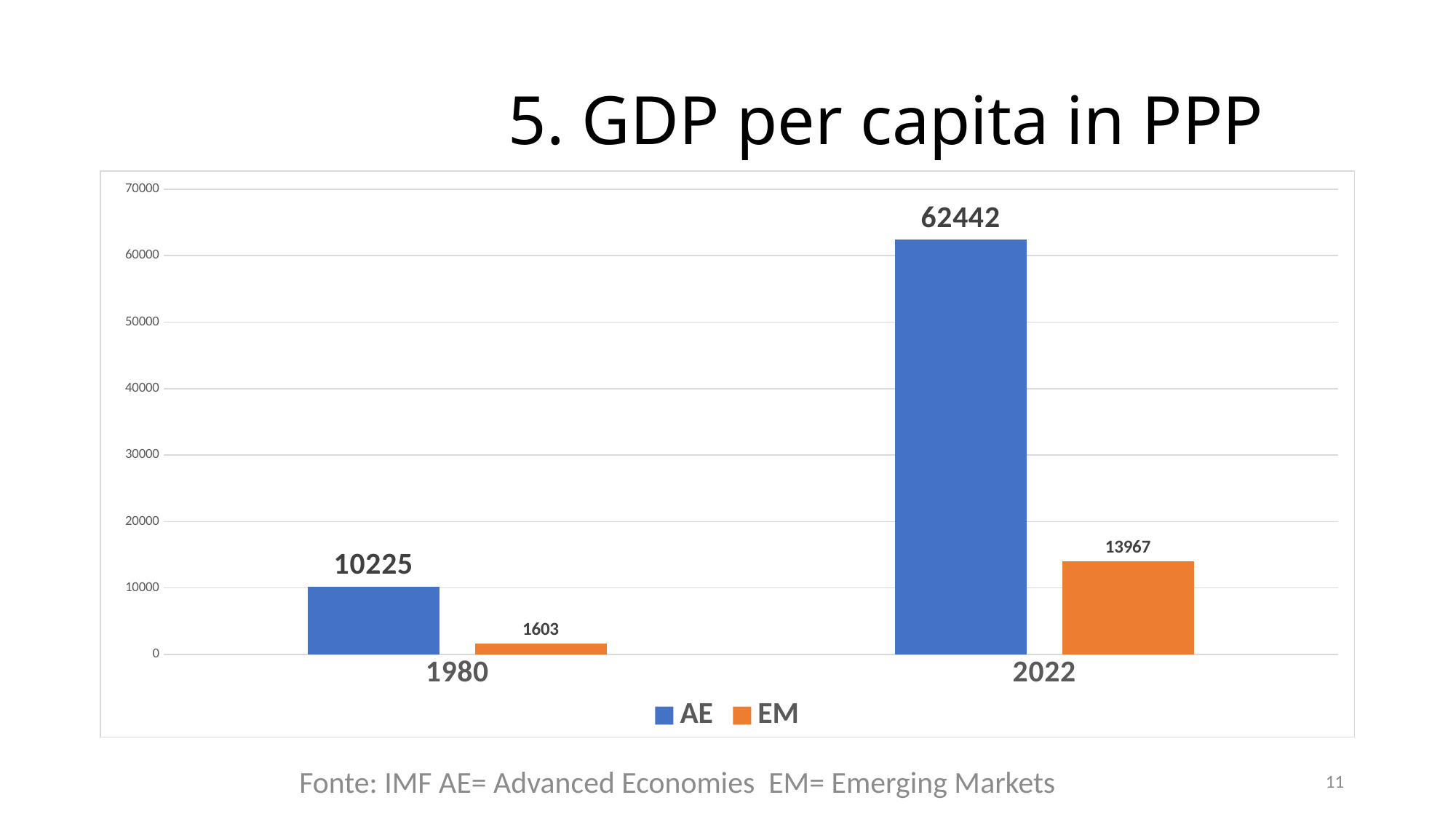
What is the value for EM in 2022? 13967 Which is larger: EM in 2022 or AE in 1980? EM in 2022 What is the value for AE in 1980? 10225 Which bar has the lowest value on the chart? EM in 1980 What kind of chart is shown on the slide? Bar chart What is the value for EM in 1980? 1603 What is the difference between the AE values in 2022 and 1980? 52217 Does the EM value rise or fall from 1980 to 2022? Rise What is the value for AE in 2022? 62442 Which series has the highest value in 2022? AE What is the difference between the AE and EM values in 2022? 48475 How many series does the legend list? 2